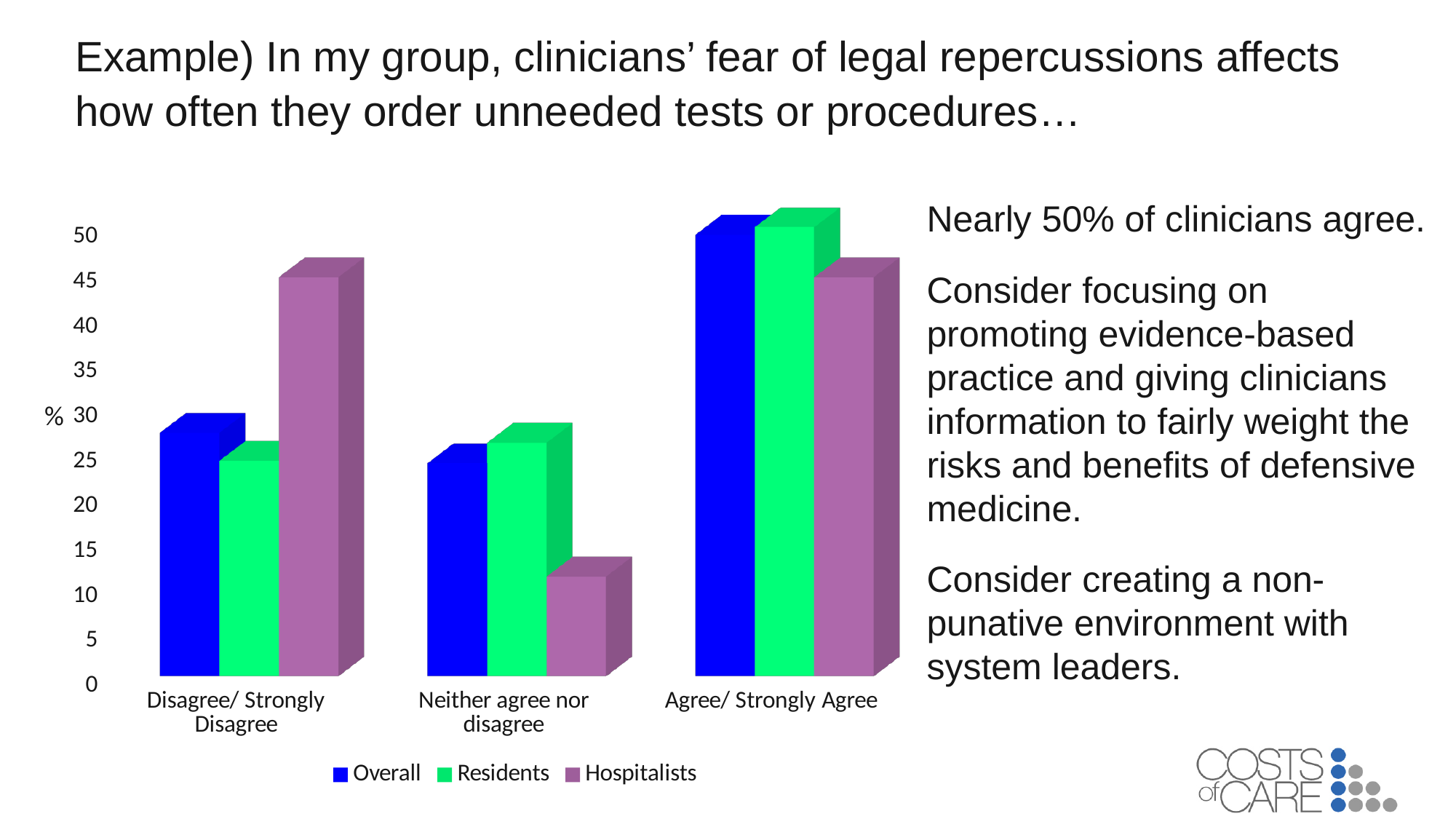
Is the Overall value for Agree/ Strongly Agree greater or less than 40? greater In the Disagree/ Strongly Disagree category, which series has the highest bar? Hospitalists For the Hospitalists series, which category has the lowest value? Neither agree nor disagree Is the Hospitalists value for Neither agree nor disagree greater or less than 15? less In the Neither agree nor disagree category, which series has the lowest bar? Hospitalists What label is shown on the vertical axis of the chart? % For the Overall series, which category has the highest value? Agree/ Strongly Agree How many response categories are shown on the x axis of the chart? 3 How many series does the chart legend list? 3 What kind of chart is shown on the slide? bar chart In the Disagree/ Strongly Disagree category, is the value for Hospitalists or Residents larger? Hospitalists What are the three series named in the chart legend? Overall, Residents, Hospitalists